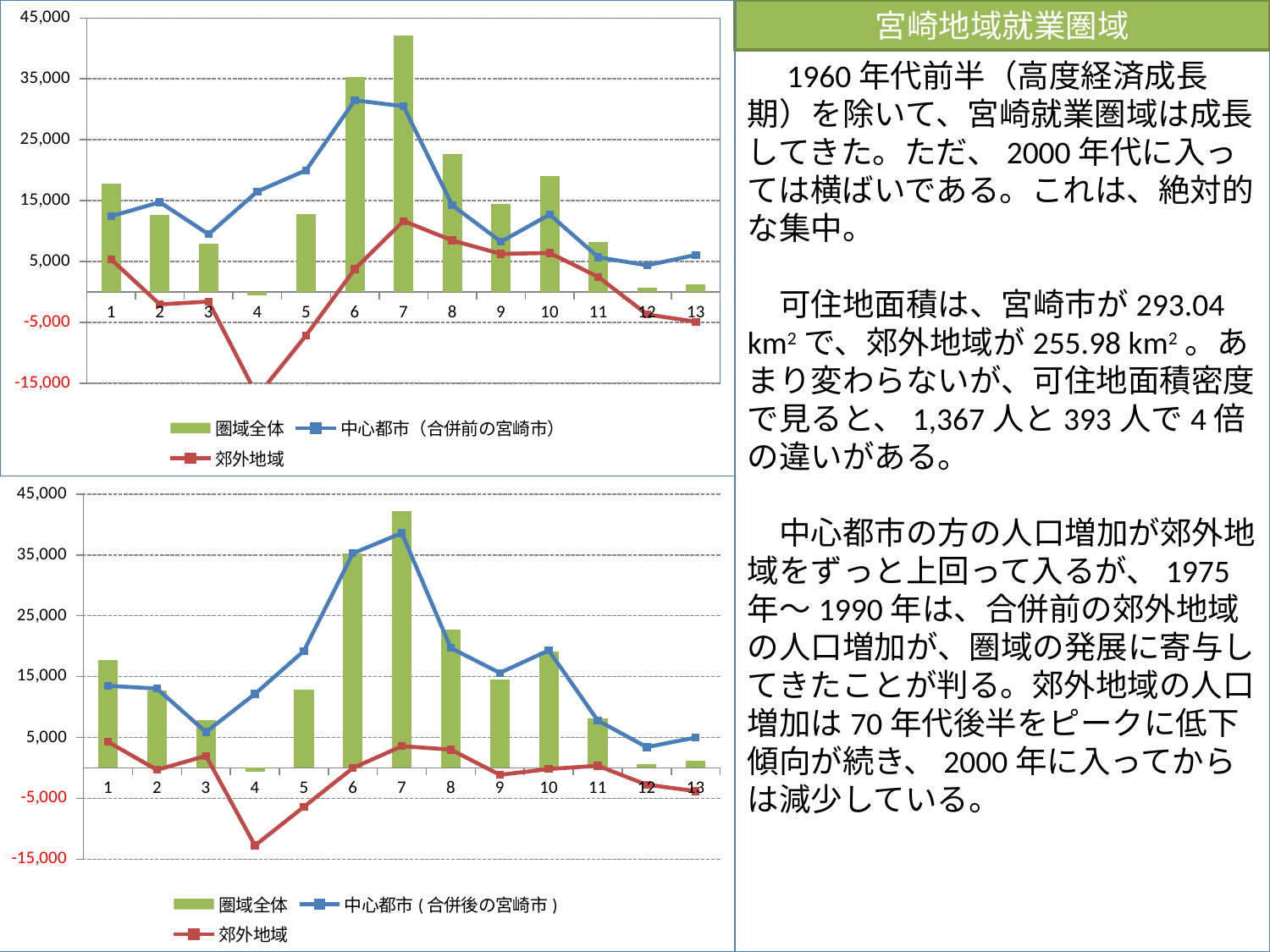
In the bottom chart, at which category is the 郊外地域 line at its lowest point? 4 In the top chart, at which category is the 圏域全体 bar highest? 7 What kind of chart is the top chart on the slide? A combined bar and line chart How many series does the legend of the bottom chart list? 3 In the bottom chart, which series is drawn as a blue line? 中心都市 (合併後の宮崎市) In the top chart, at which category is the 郊外地域 line at its lowest point? 4 In the bottom chart, is the 郊外地域 value at category 4 greater or less than -5,000? less In the top chart, is the 圏域全体 bar at category 1 greater or less than 15,000? greater In the top chart, is the 圏域全体 bar at category 7 greater or less than 35,000? greater In the top chart at category 7, which is larger: the 中心都市 value or the 郊外地域 value? 中心都市 In the bottom chart, at which category is the 圏域全体 bar highest? 7 How many categories are shown on the x axis of the top chart? 13